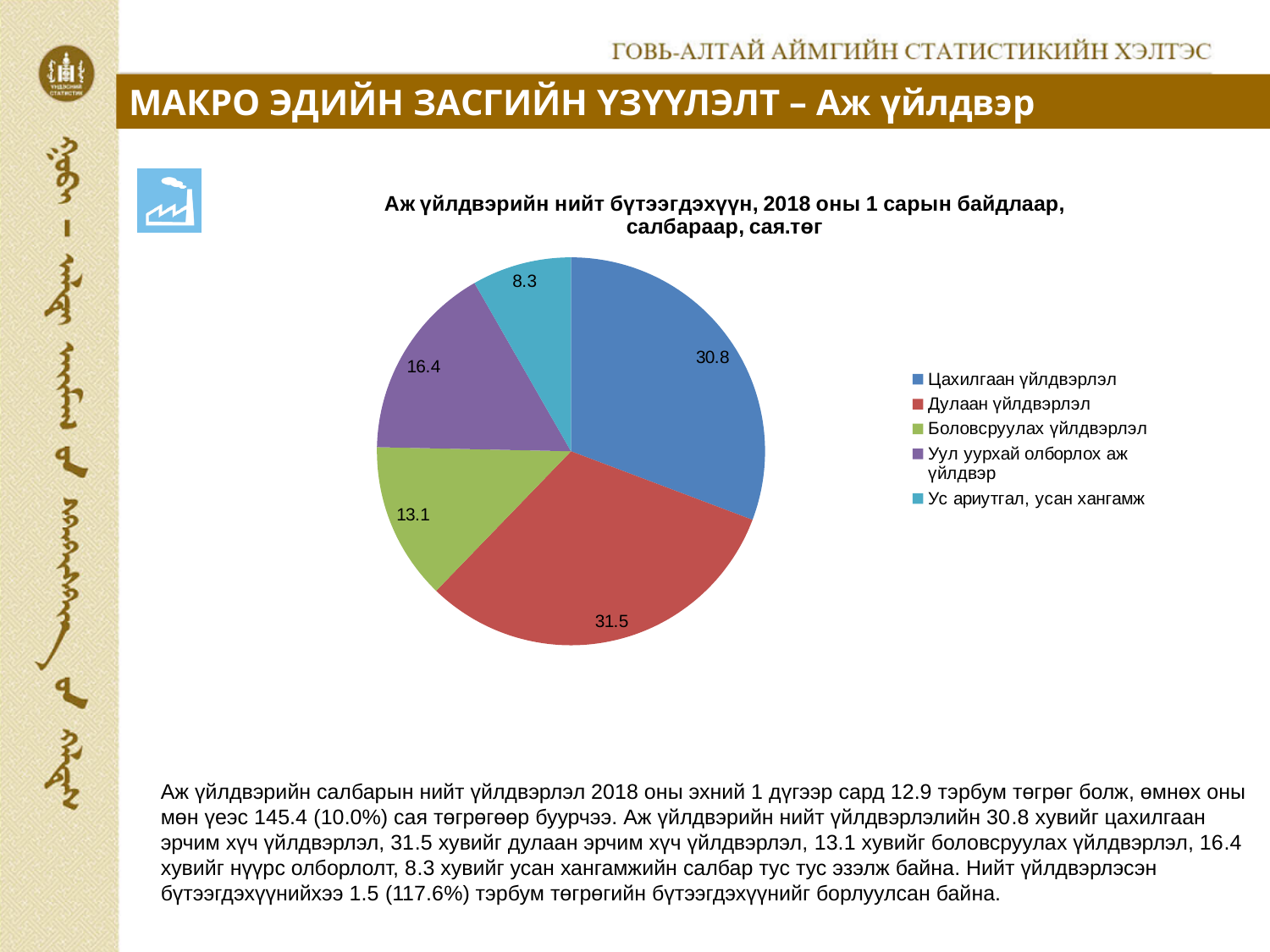
Which is larger: the value for Цахилгаан үйлдвэрлэл or the value for Боловсруулах үйлдвэрлэл? Цахилгаан үйлдвэрлэл What type of chart is shown on the slide? Pie chart What is the value shown for Дулаан үйлдвэрлэл in the pie chart? 31.5 Which category has the smallest slice in the pie chart? Ус ариутгал, усан хангамж What is the value shown for Ус ариутгал, усан хангамж in the pie chart? 8.3 What colour is the slice for Уул уурхай олборлох аж үйлдвэр? Purple What is the value shown for Боловсруулах үйлдвэрлэл in the pie chart? 13.1 What is the value shown for Уул уурхай олборлох аж үйлдвэр in the pie chart? 16.4 What is the value shown for Цахилгаан үйлдвэрлэл in the pie chart? 30.8 Which category has the largest slice in the pie chart? Дулаан үйлдвэрлэл What is the difference between the values for Уул уурхай олборлох аж үйлдвэр and Боловсруулах үйлдвэрлэл? 3.3 How many categories does the pie chart show? 5